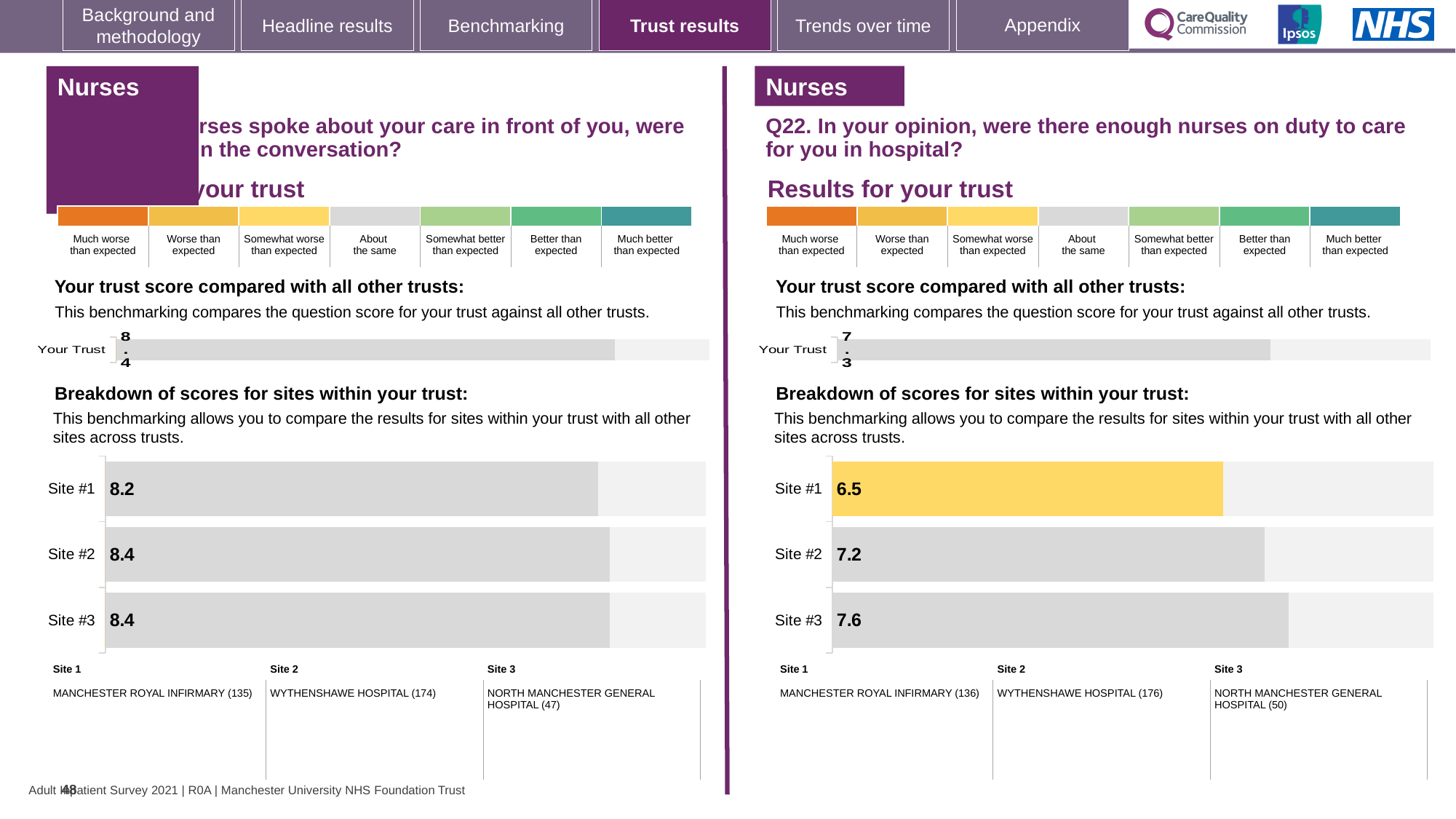
On the left-hand site breakdown chart, what is the difference between the scores for Site #2 and Site #1? 0.2 On the right-hand Q22 site breakdown chart, which has the larger score, Site #2 or Site #3? Site #3 On the left-hand 'Your trust score compared with all other trusts' chart, what is the value shown for Your Trust? 8.4 On the right-hand Q22 'Your trust score compared with all other trusts' chart, what is the value shown for Your Trust? 7.3 On the left-hand site breakdown chart, which site has the lowest score? Site #1 On the right-hand Q22 site breakdown chart, what is the score for Site #1? 6.5 On the right-hand Q22 site breakdown chart, what is the score for Site #3? 7.6 On the right-hand Q22 site breakdown chart, which site has the lowest score? Site #1 On the right-hand Q22 site breakdown chart, which site has the highest score? Site #3 How many sites are shown on the right-hand Q22 site breakdown chart? 3 On the right-hand Q22 site breakdown chart, what is the difference between the scores for Site #3 and Site #1? 1.1 On the left-hand site breakdown chart, what is the score for Site #1? 8.2